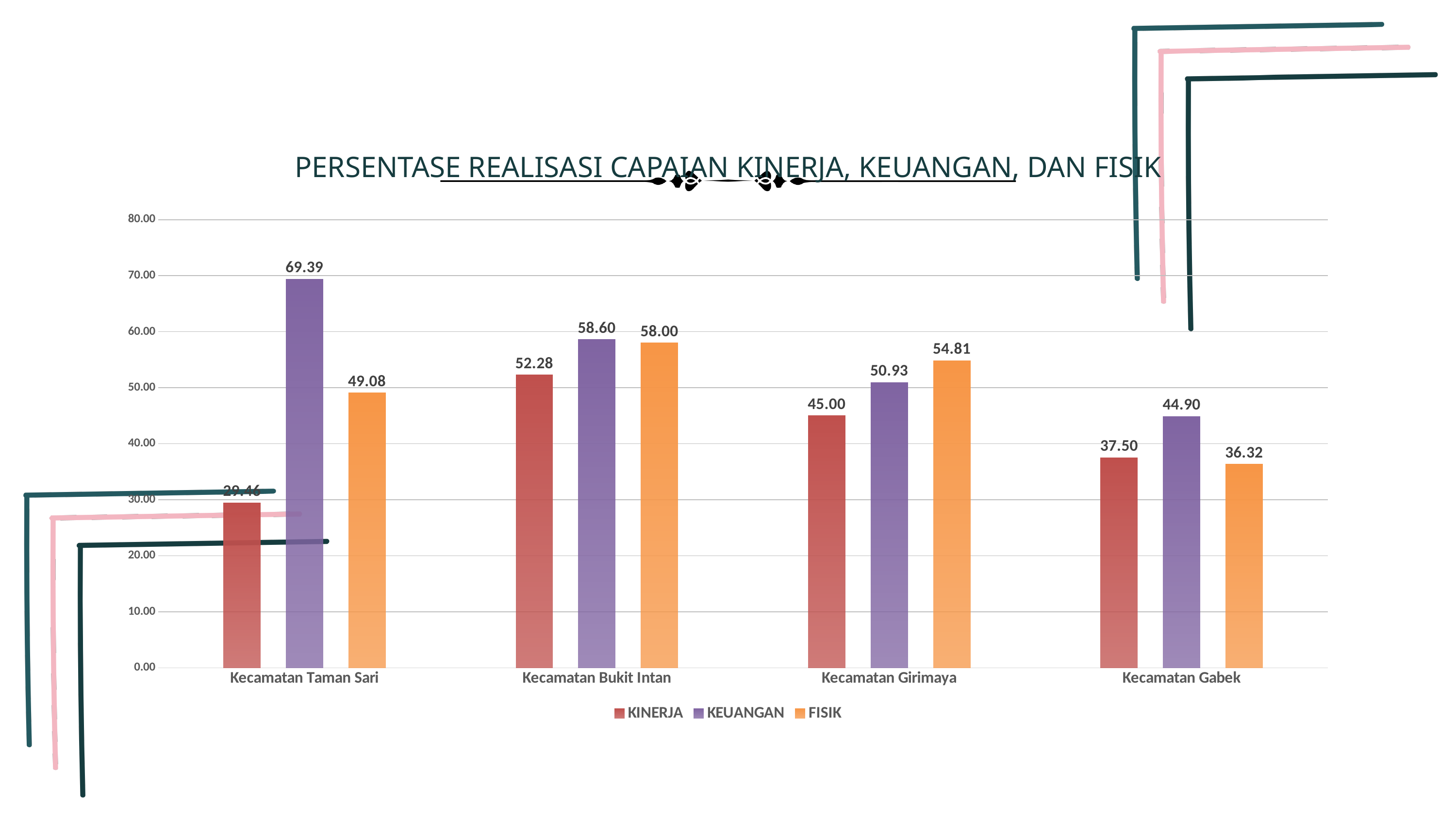
How many categories are shown on the x axis? 4 What is the KEUANGAN value for Kecamatan Taman Sari? 69.39 What is the difference between the KEUANGAN and KINERJA values for Kecamatan Bukit Intan? 6.32 Which category has the lowest FISIK value? Kecamatan Gabek What is the FISIK value for Kecamatan Gabek? 36.32 Is the KINERJA value for Kecamatan Gabek greater or less than 40.00? less How many series does the legend list? 3 What is the FISIK value for Kecamatan Bukit Intan? 58.00 What kind of chart is shown on the slide? Bar chart Which category has the highest KEUANGAN value? Kecamatan Taman Sari What is the KINERJA value for Kecamatan Girimaya? 45.00 Which is larger for Kecamatan Girimaya, the KEUANGAN value or the FISIK value? FISIK